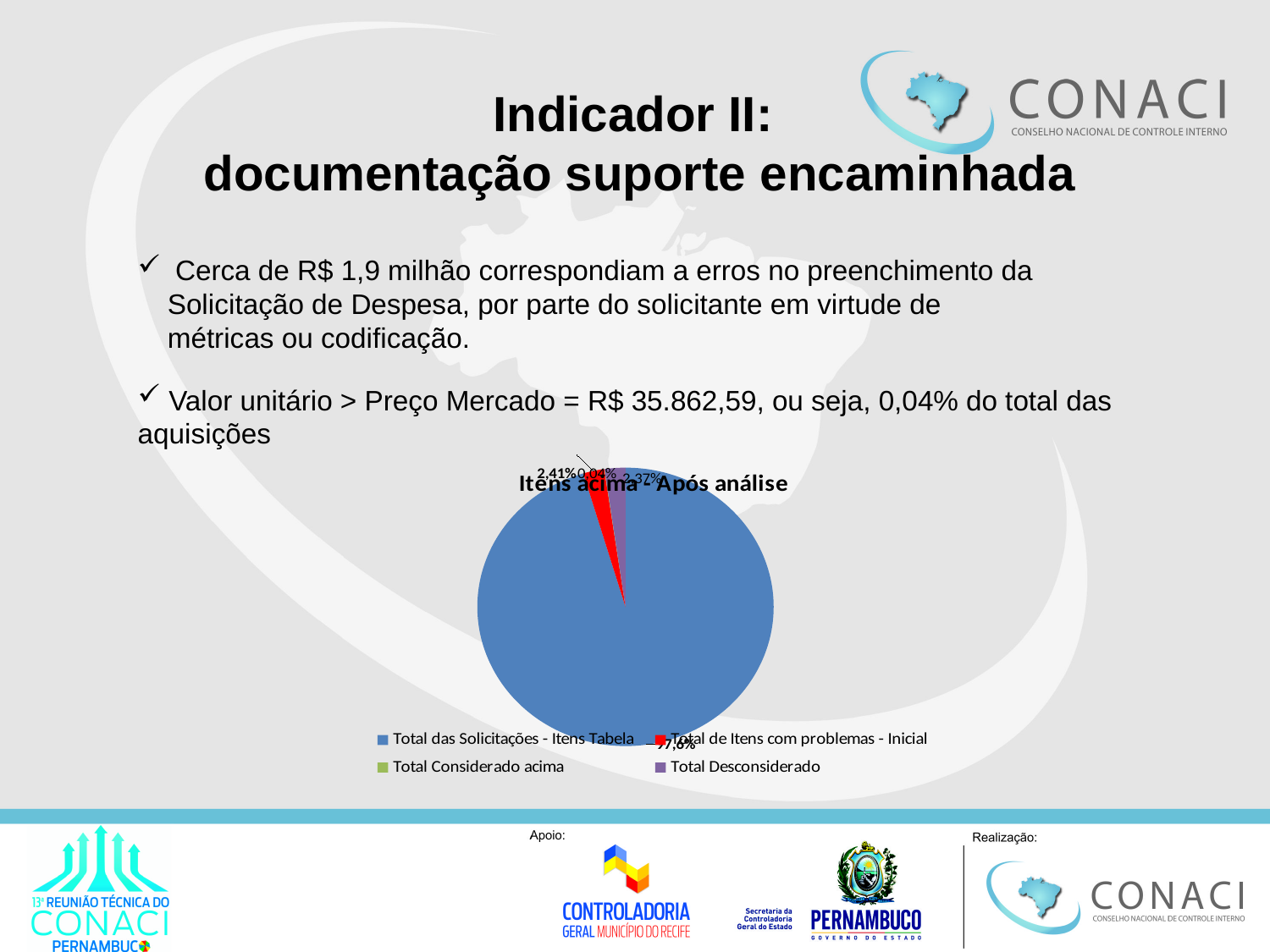
Which category has the largest slice in the pie chart? Total das Solicitações - Itens Tabela Which category has the smallest slice in the pie chart? Total Considerado acima What is the title of the pie chart? Itens acima - Após análise What colour is the largest slice of the pie chart? blue What percentage is shown for the red slice (Total de Itens com problemas - Inicial)? 2,41% How many entries does the legend of the pie chart list? 4 How many slices does the pie chart have according to its legend? 4 What kind of chart is shown on the slide? pie chart Which is larger in the pie chart: Total das Solicitações - Itens Tabela or Total de Itens com problemas - Inicial? Total das Solicitações - Itens Tabela